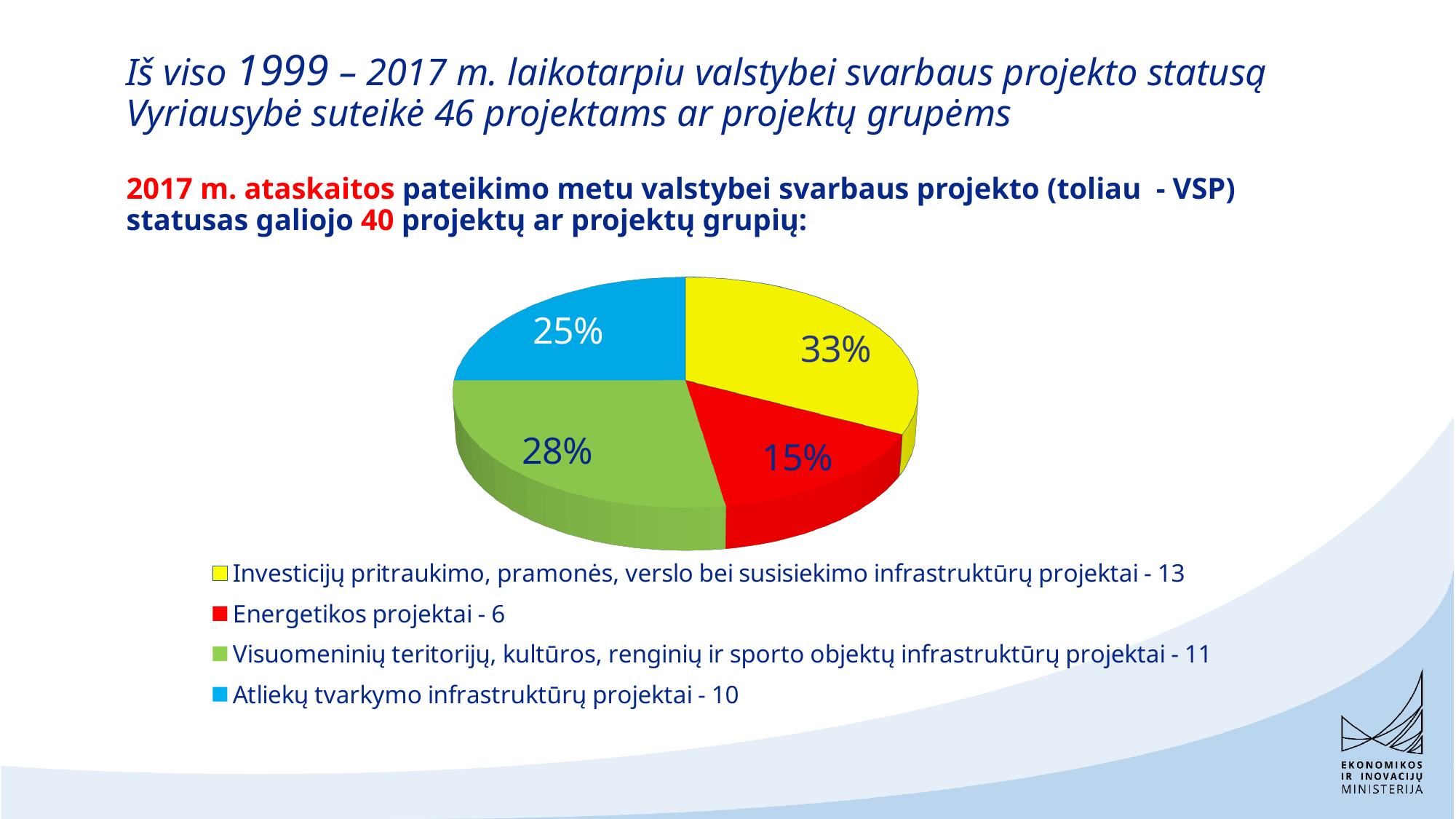
Which category has the largest slice of the pie? Investicijų pritraukimo, pramonės, verslo bei susisiekimo infrastruktūrų projektai What share of the pie does the "Visuomeninių teritorijų, kultūros, renginių ir sporto objektų infrastruktūrų projektai" slice represent? 28% Which category has the smallest slice of the pie? Energetikos projektai How many projects does the legend list for "Energetikos projektai"? 6 How many slices does the pie chart have? 4 What share of the pie does the "Energetikos projektai" slice represent? 15% What kind of chart is shown on the slide? pie chart What is the difference in percentage points between the largest slice (33%) and the smallest slice (15%)? 18 percentage points What share of the pie does the "Investicijų pritraukimo, pramonės, verslo bei susisiekimo infrastruktūrų projektai" slice represent? 33% How many projects does the legend list for "Atliekų tvarkymo infrastruktūrų projektai"? 10 Which colour represents "Energetikos projektai" in the pie chart? red